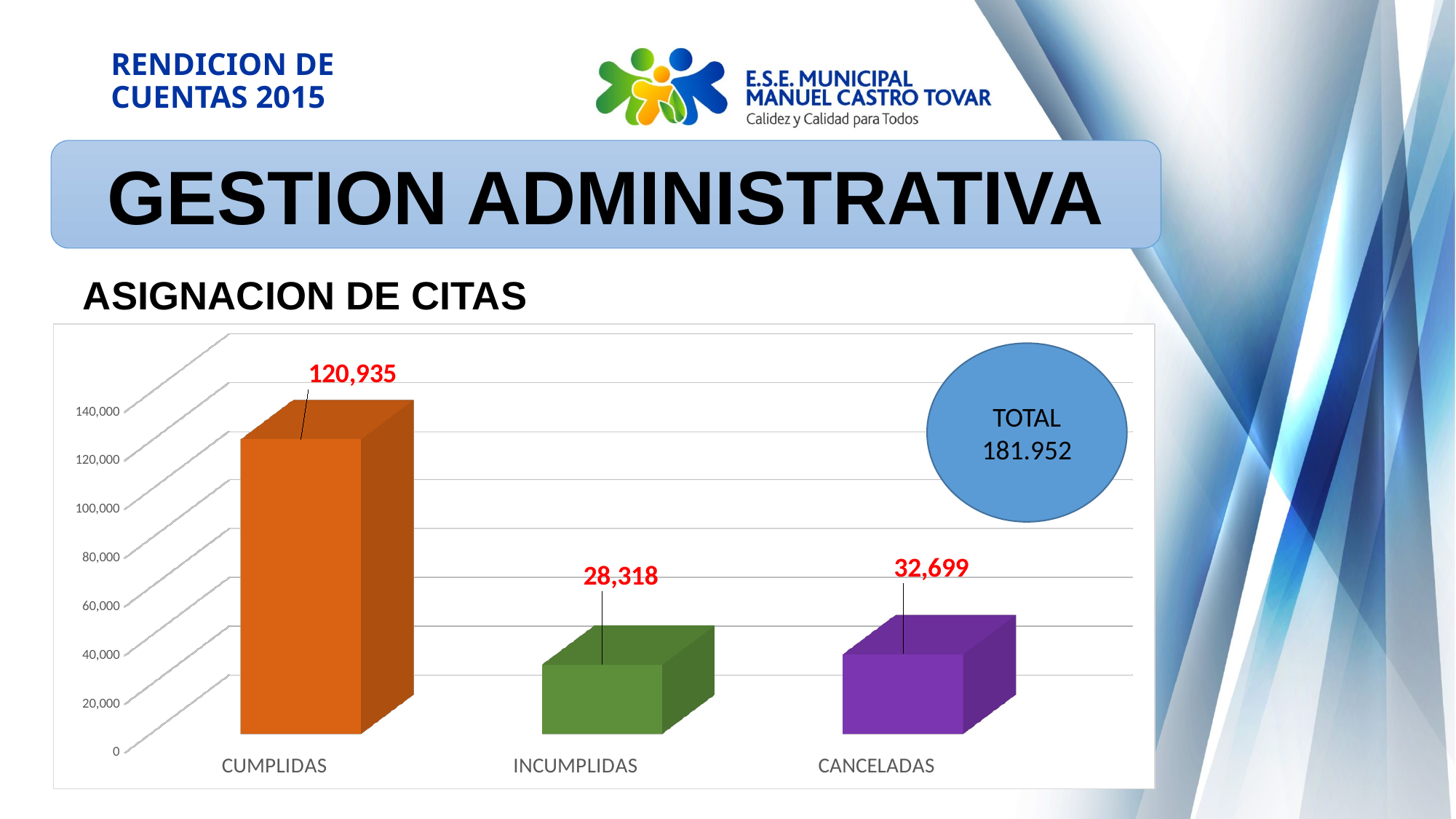
What total is shown in the circle next to the chart? 181.952 What is the difference between the values for CUMPLIDAS and CANCELADAS? 88,236 What is the value for INCUMPLIDAS? 28,318 Which category has the lowest value? INCUMPLIDAS What is the value for CANCELADAS? 32,699 What is the value for CUMPLIDAS? 120,935 Which category has the highest value? CUMPLIDAS What is the difference between the values for CANCELADAS and INCUMPLIDAS? 4,381 How many categories are shown in the chart? 3 Which is larger, the value for CANCELADAS or the value for INCUMPLIDAS? CANCELADAS What kind of chart is shown on the slide? bar chart Is the value for CUMPLIDAS greater or less than 100,000? greater